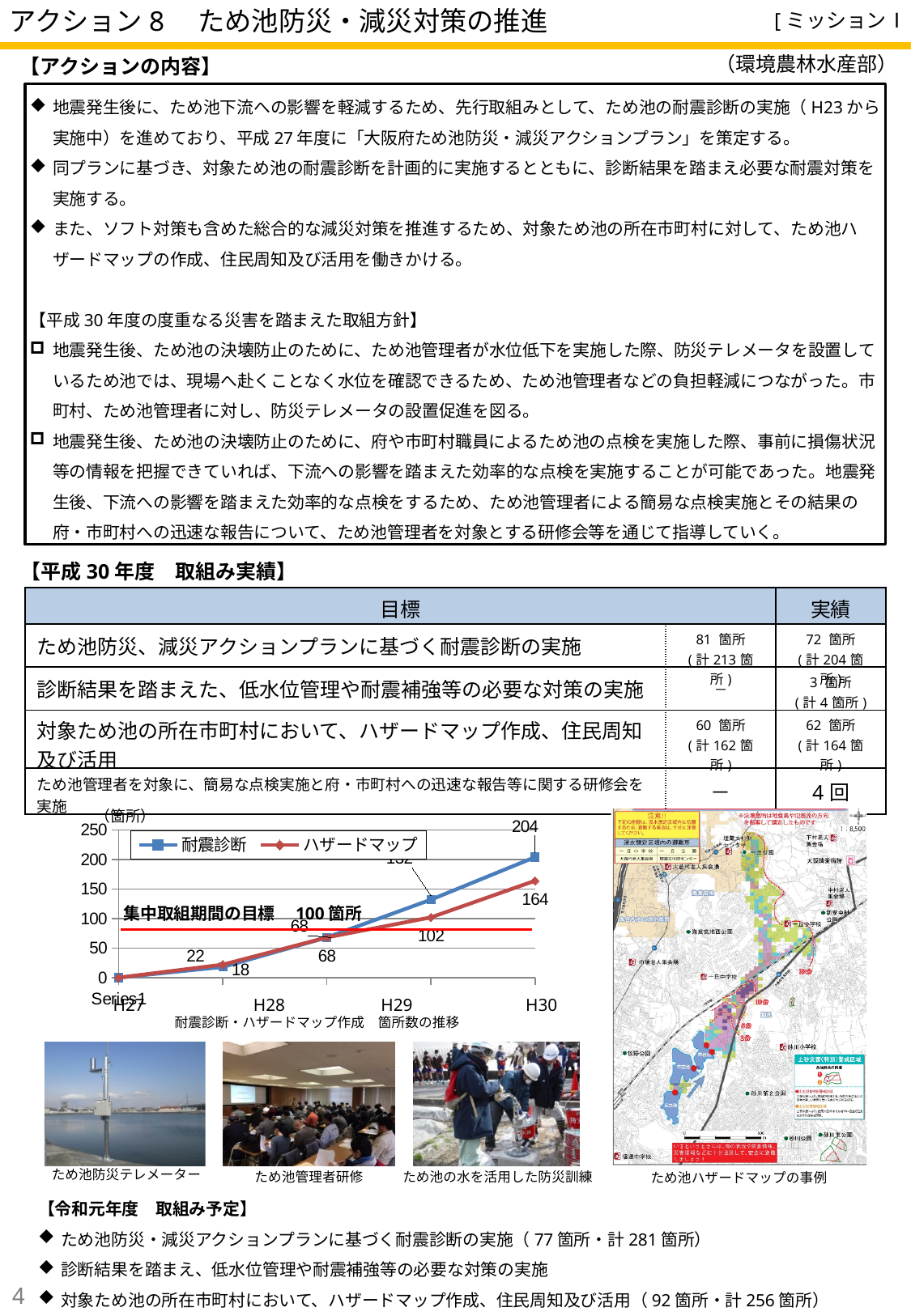
In the line chart, at which year is the value for ハザードマップ highest? H30 In the line chart, what is the value for 耐震診断 at H28? 18 How many series does the legend of the line chart list? 2 In the line chart, what is the value for 耐震診断 at H30? 204 In the line chart, what is the value for ハザードマップ at H28? 22 In the line chart, what is the value for ハザードマップ at H29? 102 In the line chart, what is the difference between 耐震診断 and ハザードマップ at H30? 40 In the line chart, what is the value for ハザードマップ at H30? 164 In the line chart, which series has the larger value at H30, 耐震診断 or ハザードマップ? 耐震診断 What kind of chart is shown at the bottom left of the slide (耐震診断・ハザードマップ作成 箇所数の推移)? line chart What target value is marked by the horizontal red line in the line chart (集中取組期間の目標)? 100 箇所 In the line chart, do the values for 耐震診断 rise or fall from H27 to H30? rise